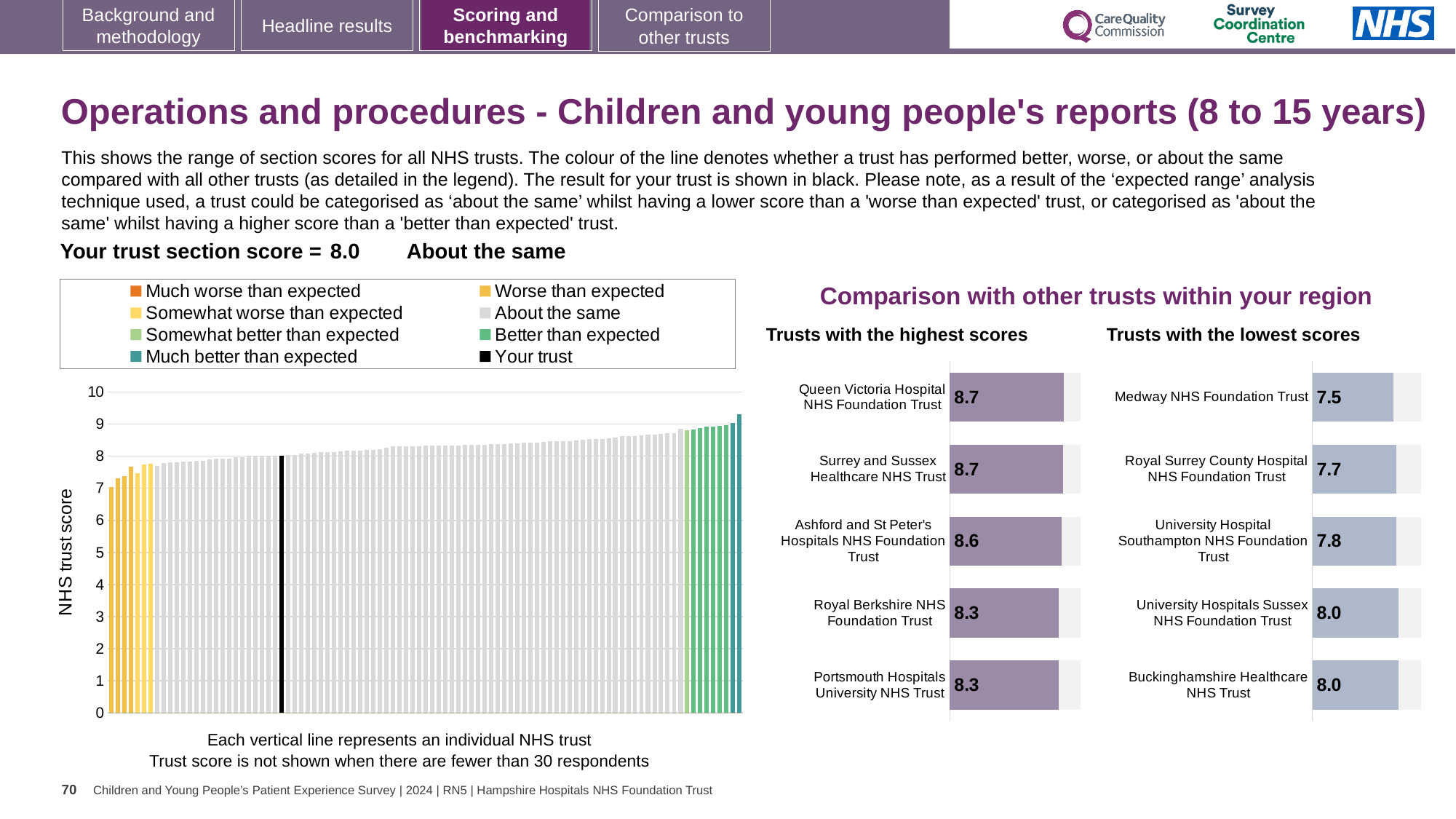
How many trusts are shown in the 'Trusts with the highest scores' chart? 5 In the 'Trusts with the lowest scores' chart, what is the score for University Hospital Southampton NHS Foundation Trust? 7.8 In the 'Trusts with the lowest scores' chart, what is the difference between the scores of Buckinghamshire Healthcare NHS Trust and Medway NHS Foundation Trust? 0.5 What is the y-axis label of the main chart on the left? NHS trust score In the 'Trusts with the highest scores' chart, what is the difference between the scores of Queen Victoria Hospital NHS Foundation Trust and Portsmouth Hospitals University NHS Trust? 0.4 In the 'Trusts with the lowest scores' chart, which trust has the lowest score? Medway NHS Foundation Trust What kind of chart is the main chart on the left showing NHS trust scores? Bar chart In the 'Trusts with the highest scores' chart, which has the higher score: Ashford and St Peter's Hospitals NHS Foundation Trust or Royal Berkshire NHS Foundation Trust? Ashford and St Peter's Hospitals NHS Foundation Trust In the 'Trusts with the lowest scores' chart, what is the score for Medway NHS Foundation Trust? 7.5 In the 'Trusts with the highest scores' chart, what is the score for Queen Victoria Hospital NHS Foundation Trust? 8.7 In the main NHS trust score chart, do the bar values rise or fall from left to right? Rise How many entries does the legend of the main NHS trust score chart list? 8